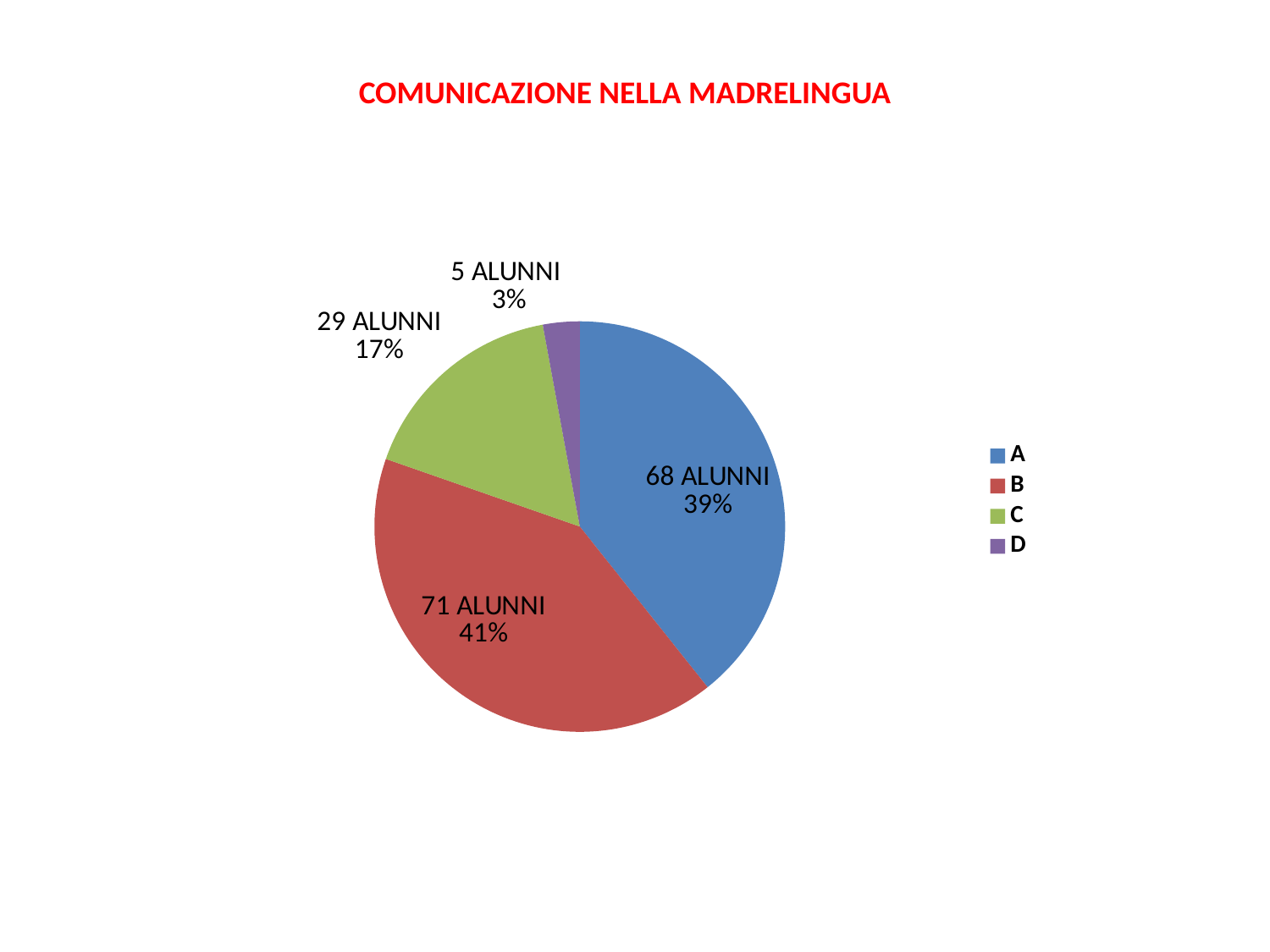
How many categories does the legend list? 4 Which category has more students, C or D? C What is the title of the chart? COMUNICAZIONE NELLA MADRELINGUA What percentage share does category D have? 3% What kind of chart is shown on the slide? pie chart How many students (alunni) are in category A? 68 ALUNNI What percentage share does category B have? 41% How many students are in category C? 29 ALUNNI What colour is the slice for category C? green What is the difference in number of students between category B and category A? 3 Which category has the smallest slice? D Which category has the largest slice? B